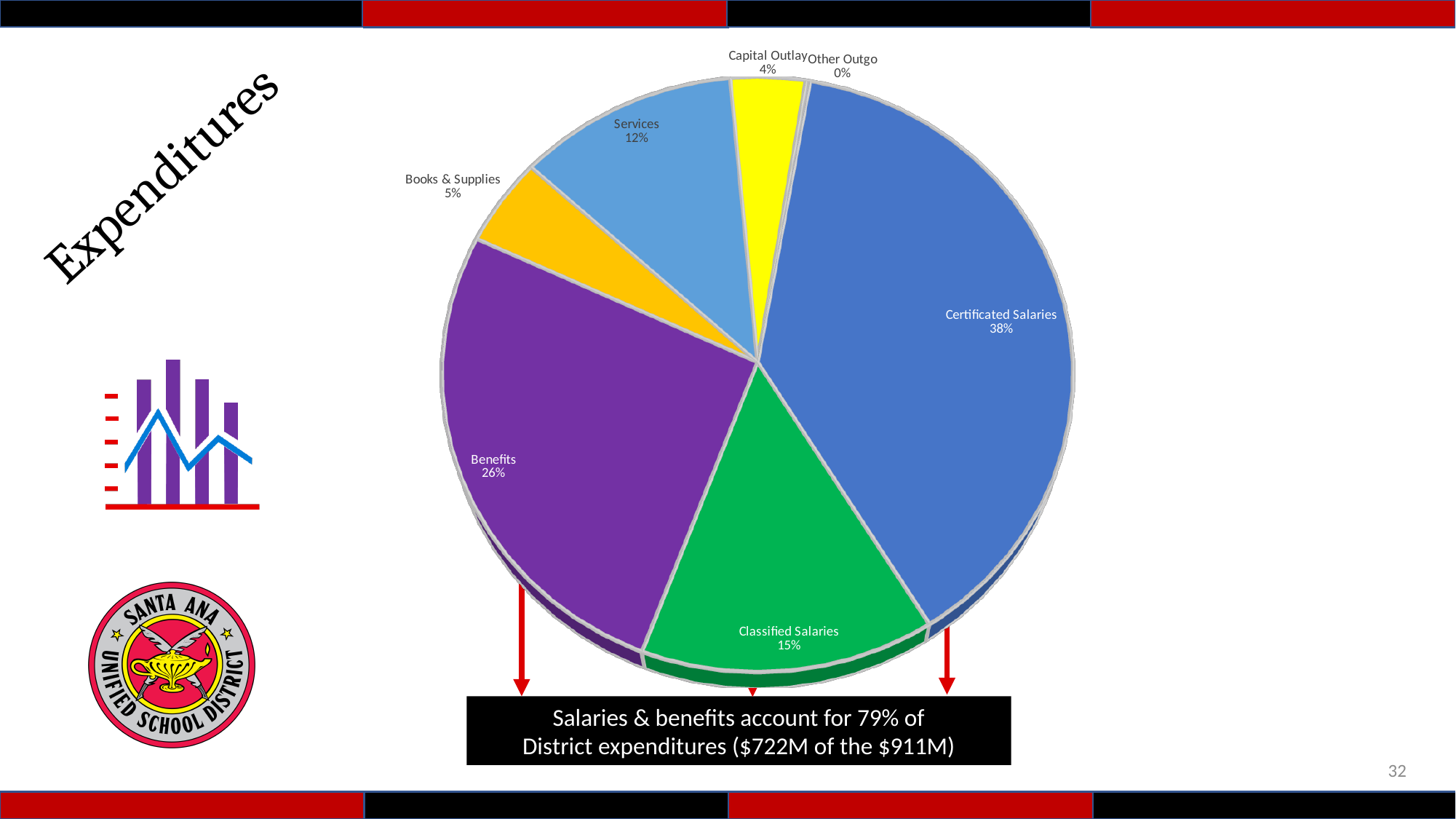
What share of expenditures is Services? 12% What share of expenditures is Books & Supplies? 5% What share of expenditures is Certificated Salaries? 38% Which category has the smallest share of expenditures? Other Outgo What share of expenditures is Capital Outlay? 4% Which is larger, Services or Books & Supplies? Services What share of expenditures is Benefits? 26% What share of expenditures is Classified Salaries? 15% How many categories are shown in the pie chart? 7 How many percentage points larger is Benefits than Classified Salaries? 11 Which category has the largest share of expenditures? Certificated Salaries What kind of chart is shown on the slide? pie chart